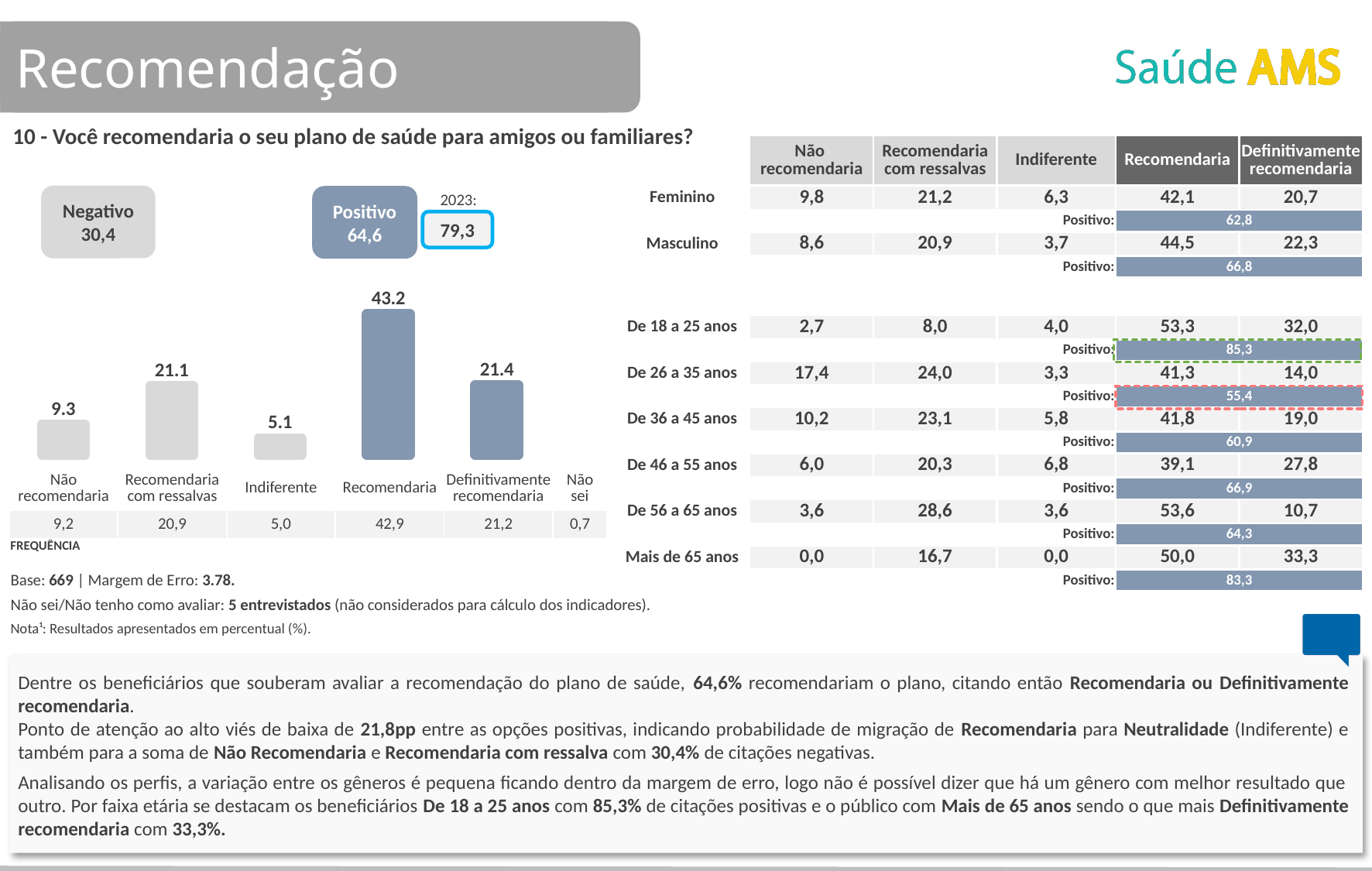
What value is shown in the Positivo box above the bar chart? 64,6 Which category has the lowest bar in the bar chart? Indiferente What is the value of the Indiferente bar in the bar chart? 5.1 What type of chart is shown on the left of the slide? bar chart Which is larger in the bar chart, Recomendaria com ressalvas or Não recomendaria? Recomendaria com ressalvas What is the difference between the Recomendaria com ressalvas bar and the Indiferente bar? 16.0 What is the value of the Não recomendaria bar in the bar chart? 9.3 What is the value of the Definitivamente recomendaria bar in the bar chart? 21.4 Which category has the highest bar in the bar chart? Recomendaria What is the difference between the Recomendaria bar and the Definitivamente recomendaria bar? 21.8 Which bars in the bar chart are coloured blue-grey rather than light grey? Recomendaria and Definitivamente recomendaria What is the value of the Recomendaria bar in the bar chart? 43.2